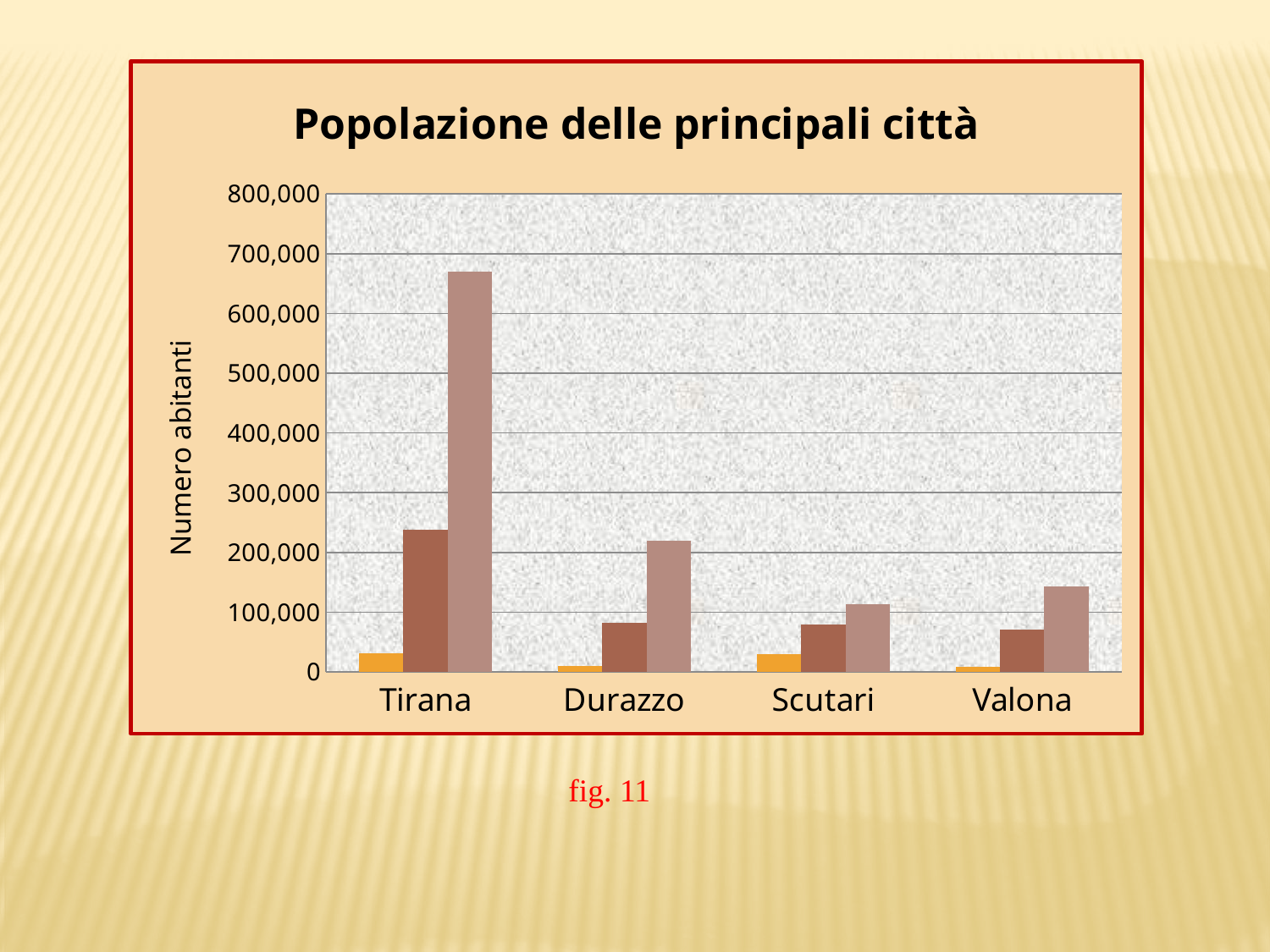
Is the tallest bar for Valona greater or less than 100,000? greater Is the tallest bar for Scutari greater or less than 200,000? less What kind of chart is shown on the slide? bar chart What is the highest value shown on the vertical axis? 800,000 How many bars are plotted for each city? 3 Is the tallest bar for Durazzo greater or less than 300,000? less What is the title of the chart? Popolazione delle principali città Which city has a larger tallest bar, Durazzo or Valona? Durazzo How many cities are shown on the x axis of the chart? 4 What is the label of the vertical axis? Numero abitanti Which city has the tallest bar in the chart? Tirana